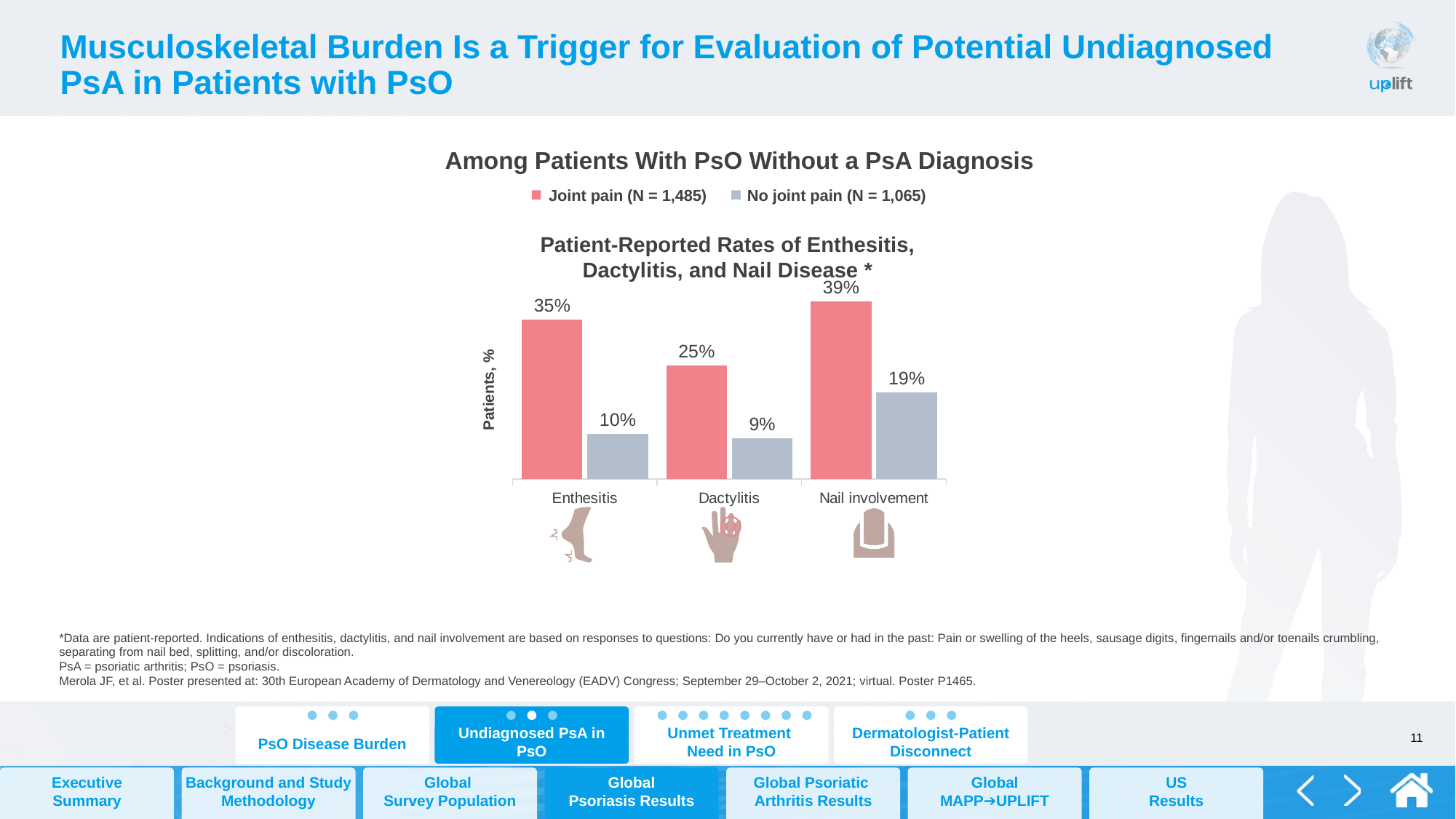
How many categories are shown on the x axis? 3 What kind of chart is shown on the slide? Bar chart How many series does the legend list? 2 What is the value for Joint pain in the Enthesitis category? 35% What is the difference between the Joint pain and No joint pain values for Nail involvement? 20% What is the value for No joint pain in the Dactylitis category? 9% What is the difference between the Joint pain and No joint pain values for Enthesitis? 25% What is the sample size (N) for the Joint pain series shown in the legend? 1,485 What is the value for No joint pain in the Nail involvement category? 19% Which is larger: the Joint pain value for Dactylitis or the No joint pain value for Nail involvement? Joint pain value for Dactylitis Which category has the highest value for the Joint pain series? Nail involvement Which category has the lowest value for the No joint pain series? Dactylitis